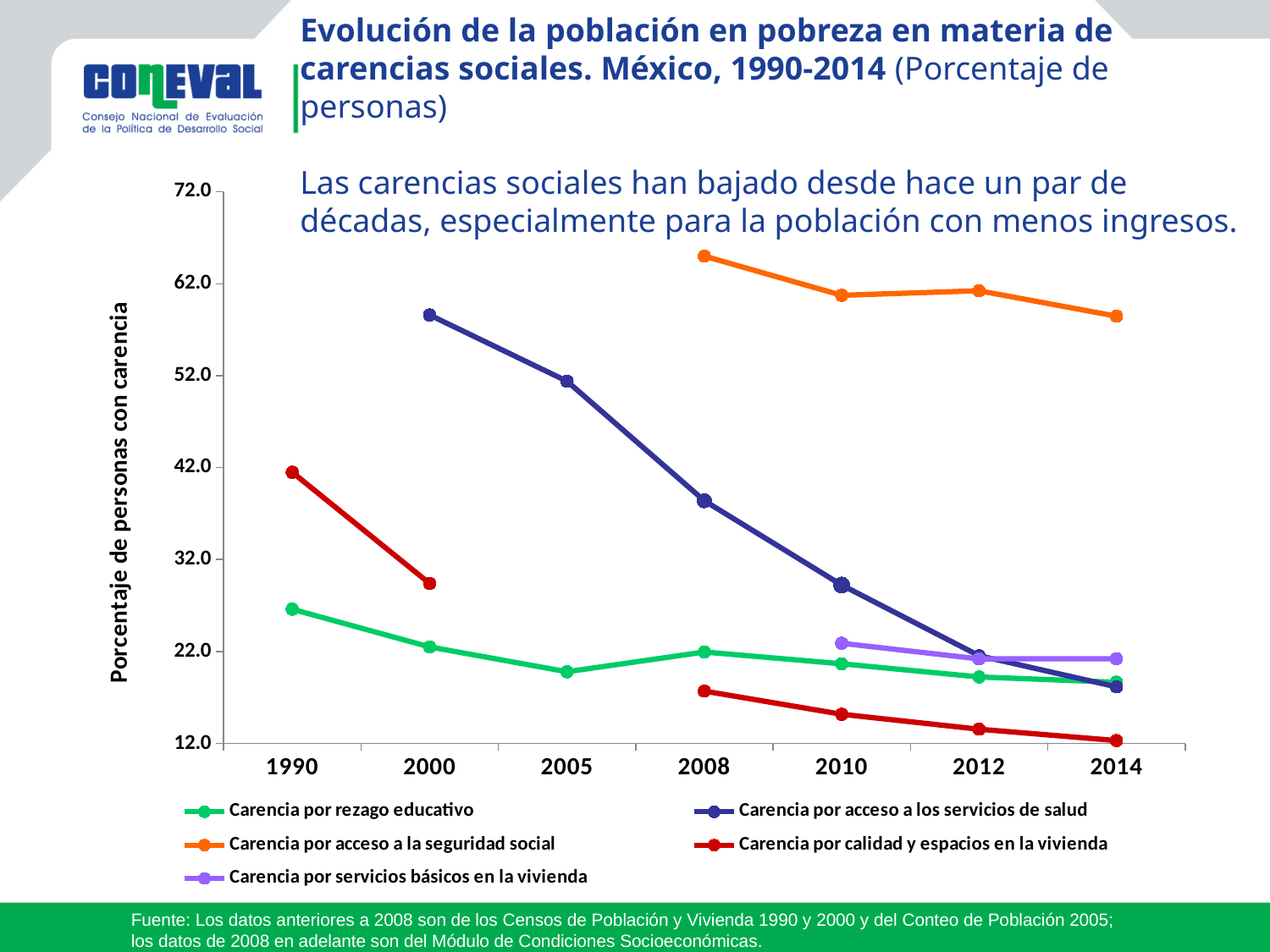
Which series has the lowest value in 2014? Carencia por calidad y espacios en la vivienda What kind of chart is shown on the slide? line chart Does the value for Carencia por acceso a los servicios de salud rise or fall from 2000 to 2014? fall Is the value for Carencia por acceso a los servicios de salud in 2000 greater or less than 52.0? greater Is the value for Carencia por acceso a los servicios de salud in 2008 greater or less than 42.0? less Is the value for Carencia por rezago educativo in 1990 greater or less than 22.0? greater How many years are shown on the x axis? 7 In 2000, which is larger: Carencia por acceso a los servicios de salud or Carencia por rezago educativo? Carencia por acceso a los servicios de salud Which series has the highest value in 2014? Carencia por acceso a la seguridad social How many series does the legend list? 5